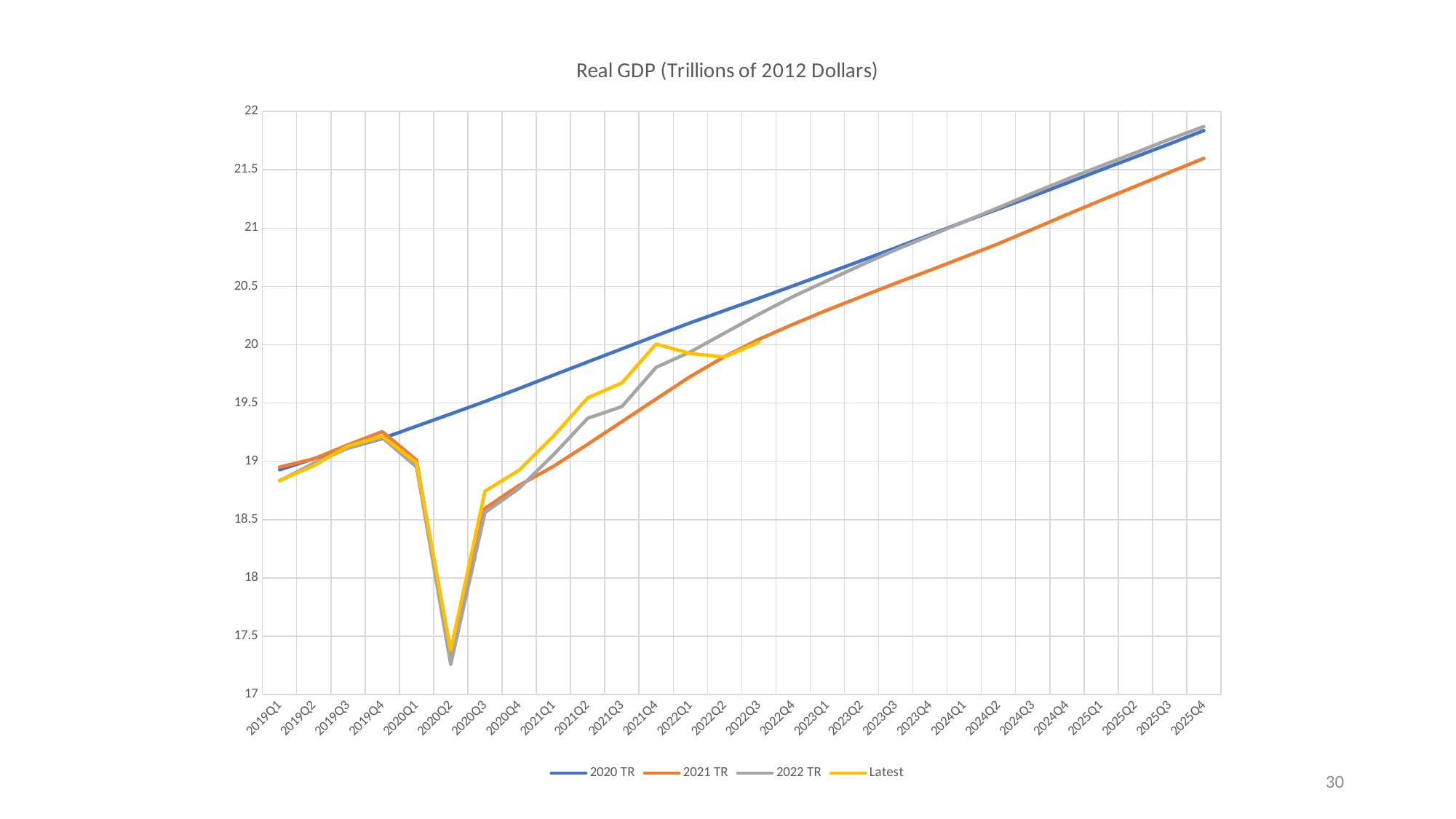
Is the value of 2022 TR at 2020Q2 greater or less than 17.5? less How many quarters are labelled along the x axis? 28 What kind of chart is shown on the slide? line chart Does the 2020 TR series rise or fall from 2019Q1 to 2025Q4? rise Is the value of 2021 TR at 2024Q1 greater or less than 21? less Is the value of 2020 TR at 2025Q4 greater or less than 21.5? greater At 2025Q4, which series is higher, 2020 TR or 2021 TR? 2020 TR What is the title of the chart? Real GDP (Trillions of 2012 Dollars) Which series is drawn in yellow? Latest How many series does the legend list? 4 In which quarter does the 2020 TR series reach its highest value? 2025Q4 In which quarter does the 2022 TR series reach its lowest value? 2020Q2